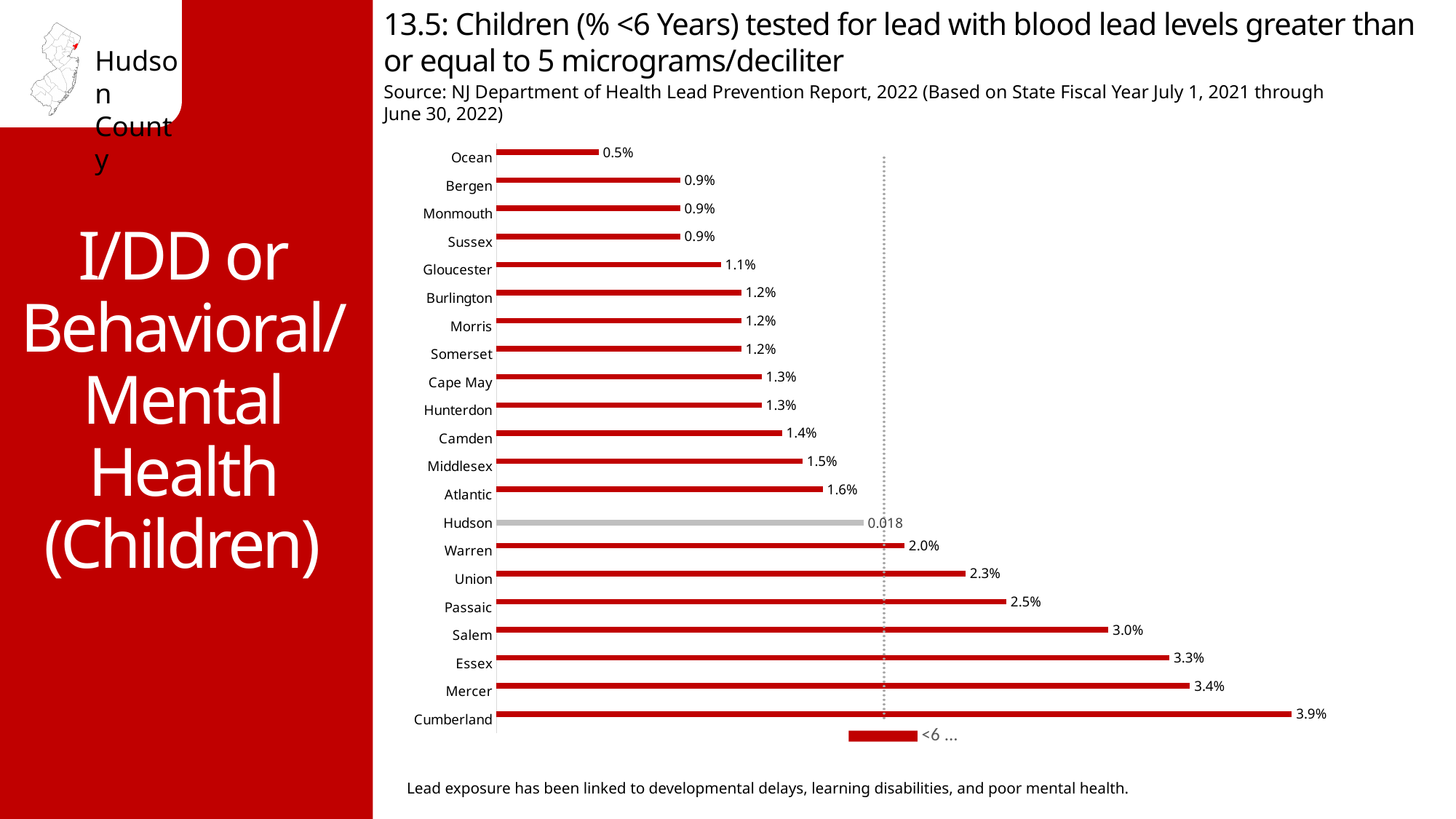
Which is larger, the value for Union or the value for Atlantic? Union How many counties are shown in the chart? 21 What is the value for Cumberland? 3.9% What value is printed next to the Hudson bar? 0.018 What is the difference between the values for Salem and Warren? 1.0% What kind of chart is shown on the slide? Bar chart What is the difference between the values for Mercer and Essex? 0.1% Which county's bar is shown in gray instead of red? Hudson What is the value for Ocean? 0.5% Which county has the lowest value? Ocean What is the value for Passaic? 2.5% Which county has the highest value? Cumberland